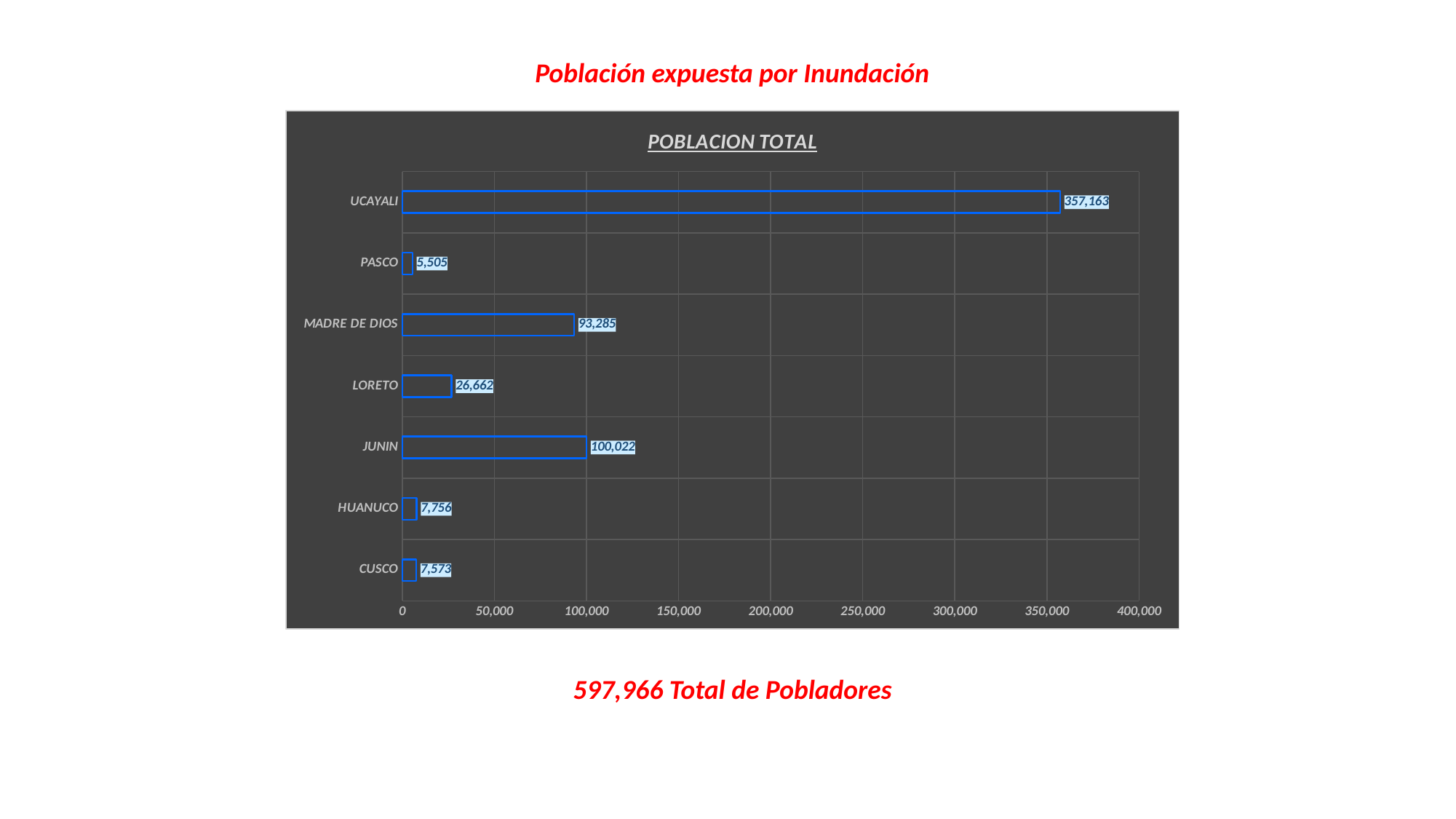
Is the value for UCAYALI greater or less than 350,000? greater How many categories are shown in the chart? 7 What is the title of the chart? POBLACION TOTAL Which category has the lowest value? PASCO What is the value for UCAYALI? 357,163 What is the value for MADRE DE DIOS? 93,285 What is the value for JUNIN? 100,022 What kind of chart is shown? bar chart What is the value for LORETO? 26,662 Which category has the highest value? UCAYALI What is the difference between the values for JUNIN and MADRE DE DIOS? 6,737 Which is larger, the value for HUANUCO or the value for CUSCO? HUANUCO